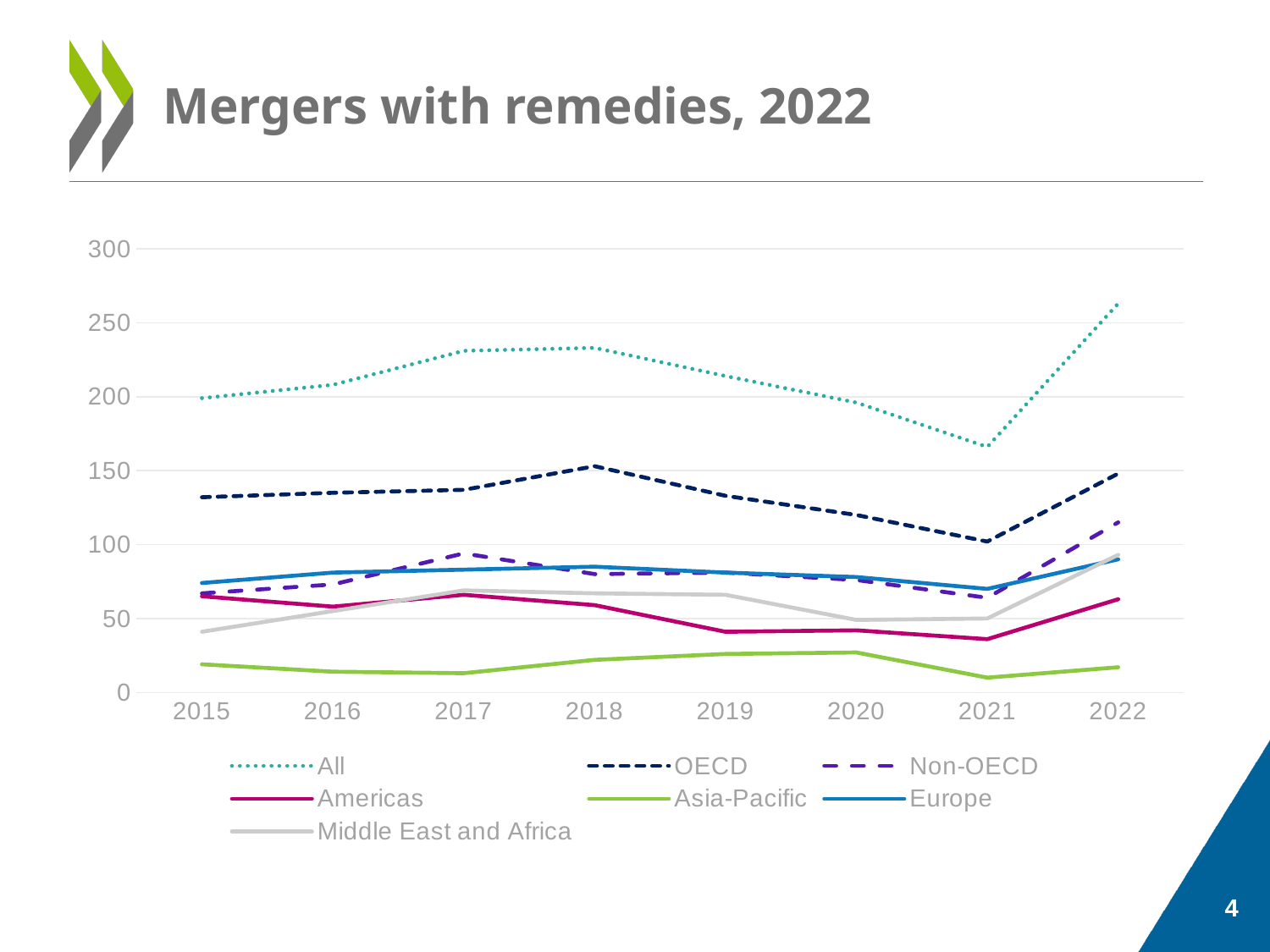
In which year does the All series reach its highest value? 2022 In which year does the Asia-Pacific series reach its lowest value? 2021 What is the title of the chart on the slide? Mergers with remedies, 2022 How many series does the legend list? 7 Does the All series rise or fall from 2018 to 2021? fall Is the value for OECD in 2020 greater or less than 150? less What kind of chart is shown on the slide? line chart In which year does the All series reach its lowest value? 2021 In 2021, which is larger: Europe or Americas? Europe Is the value for Asia-Pacific in 2020 greater or less than 50? less Is the value for All in 2022 greater or less than 250? greater How many years are shown along the x axis? 8